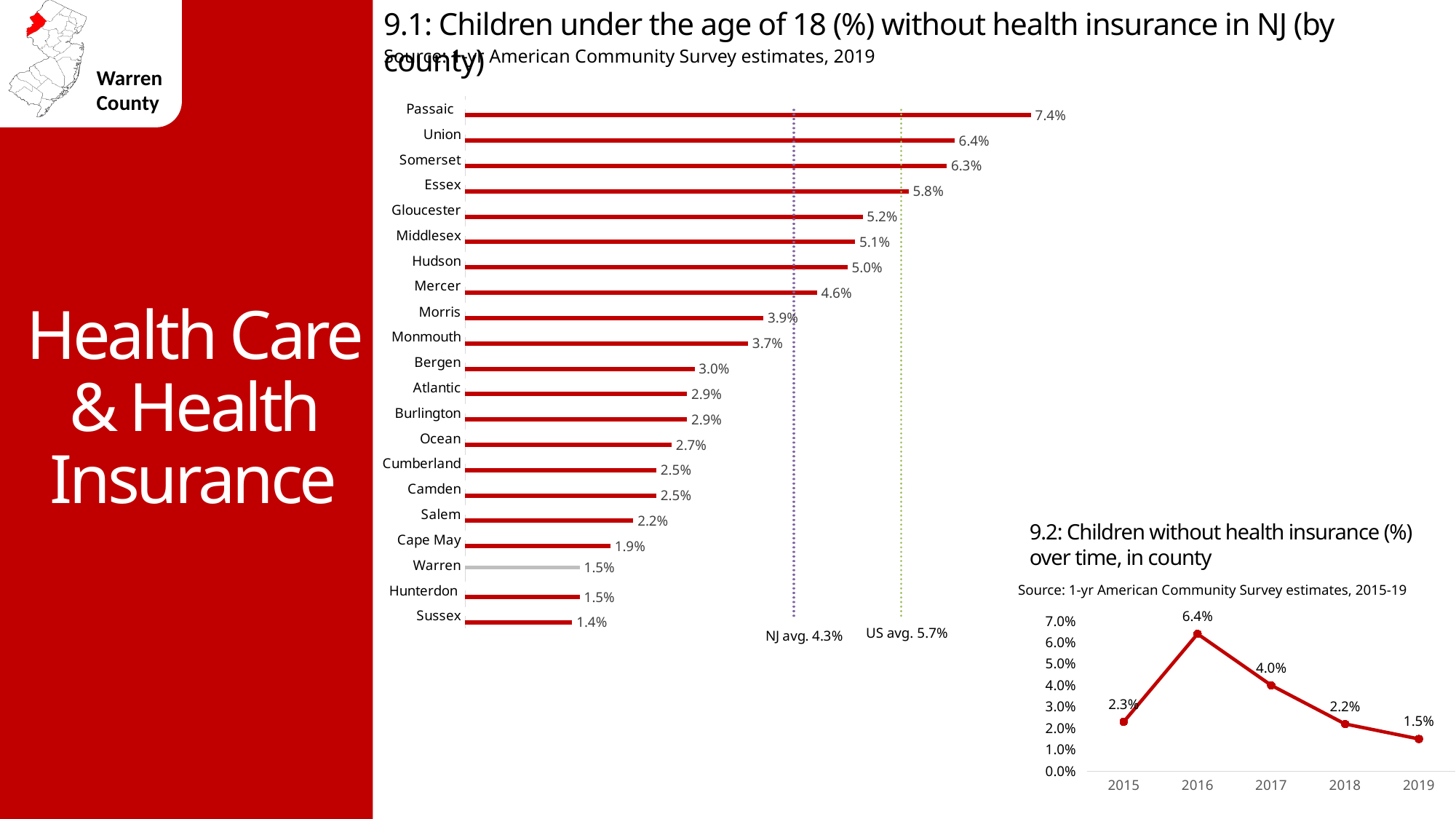
In chart 9.1 (children without health insurance by county), what is the value for Warren? 1.5% In chart 9.1 (children without health insurance by county), what is the difference between Union and Essex? 0.6% In chart 9.1 (children without health insurance by county), which is larger, Mercer or Morris? Mercer In chart 9.1 (children without health insurance by county), which county has the highest value? Passaic In chart 9.1 (children without health insurance by county), how many counties are shown? 21 What kind of chart is chart 9.2 (children without health insurance over time)? Line chart In chart 9.2 (children without health insurance over time), what is the difference between 2017 and 2018? 1.8% In chart 9.2 (children without health insurance over time), what is the value for 2016? 6.4% In chart 9.1 (children without health insurance by county), which county has the lowest value? Sussex In chart 9.1 (children without health insurance by county), what is the value for Passaic? 7.4% In chart 9.2 (children without health insurance over time), do values rise or fall from 2016 to 2019? Fall In chart 9.1 (children without health insurance by county), what is the NJ average shown by the dotted line? 4.3%